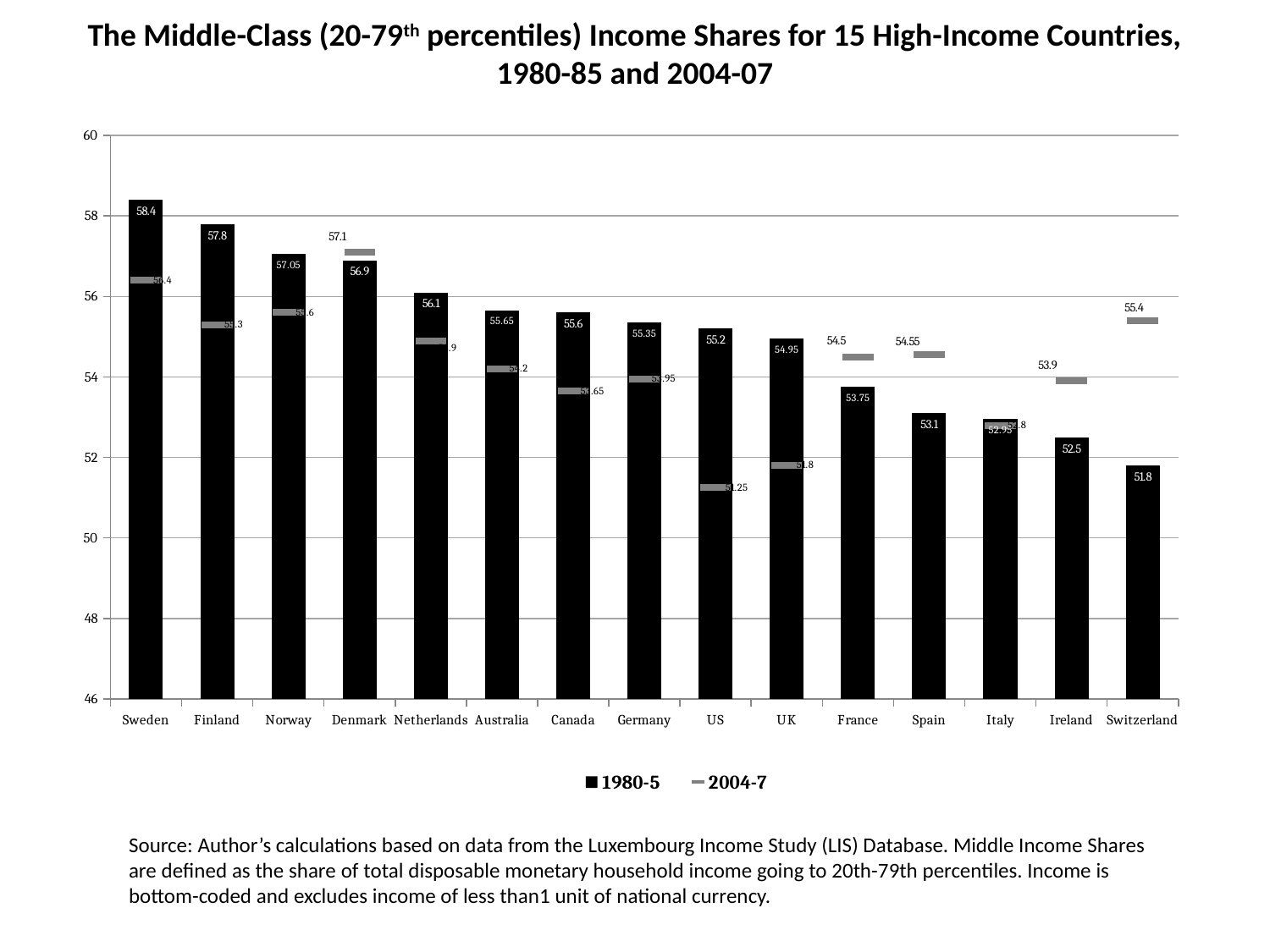
What is the 1980-5 value for Germany? 55.35 What is the 2004-7 value for Denmark? 57.1 Is the 2004-7 value for the US greater or less than 52? less How many series does the legend list? 2 What kind of chart is this? bar chart Which country has the highest 1980-5 value? Sweden Which is larger, the 1980-5 value for the US or the 1980-5 value for the UK? US What is the 2004-7 value for Switzerland? 55.4 What is the 1980-5 middle-class income share for Sweden? 58.4 What is the difference between the 1980-5 values for Sweden and Finland? 0.6 How many countries are shown on the x axis? 15 Which country has the lowest 1980-5 value? Switzerland